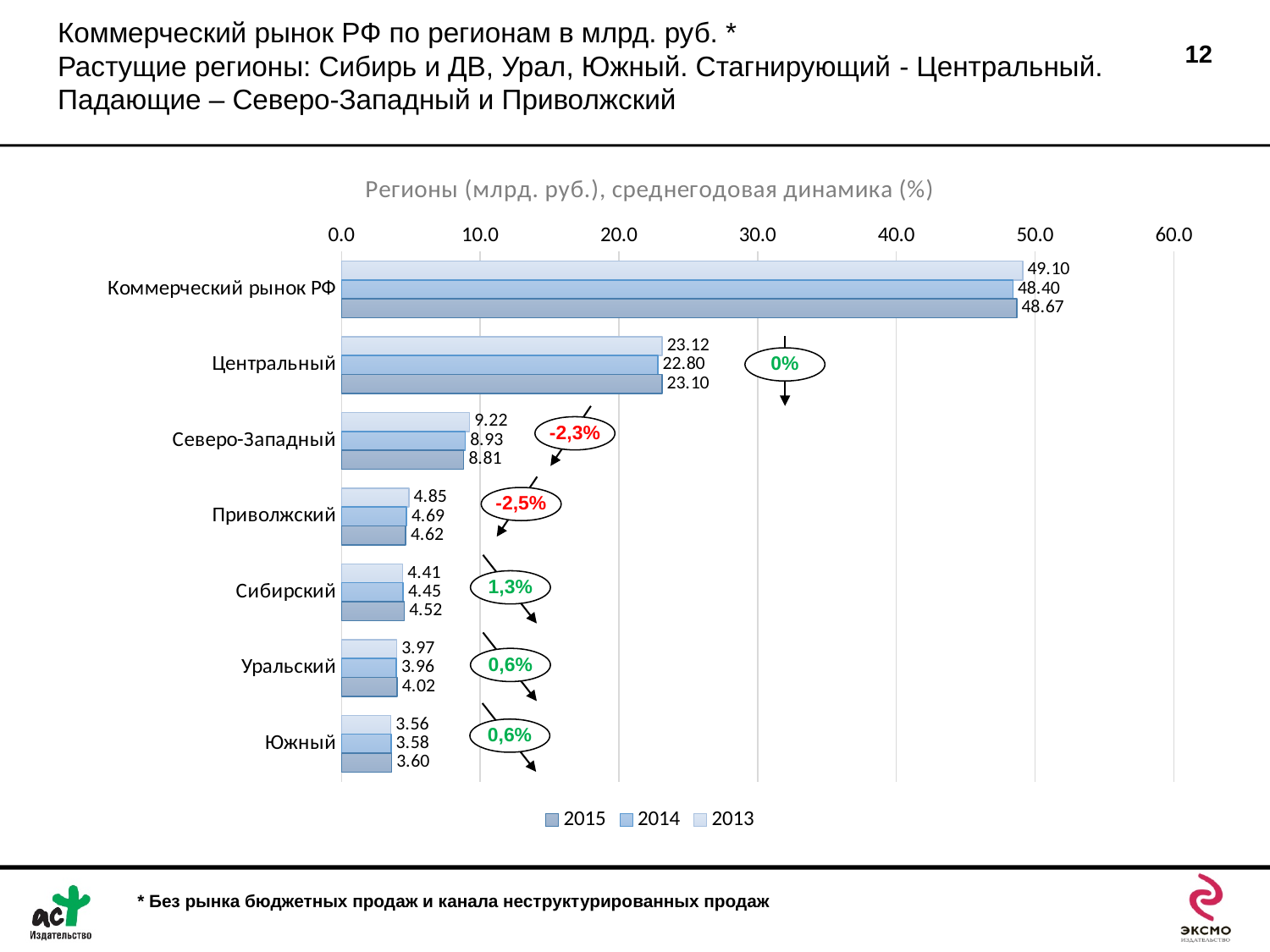
Which is larger: the 2015 value for Уральский or the 2015 value for Южный? Уральский What is the 2014 value for Сибирский? 4.45 What average annual change (%) is shown in the circle next to Северо-Западный? -2,3% What is the 2015 value for Центральный? 23.10 Which category has the highest 2013 value? Коммерческий рынок РФ What is the difference between the 2013 and 2015 values for Приволжский? 0.23 What kind of chart is shown on the slide? bar chart Which region (excluding Коммерческий рынок РФ) has the lowest 2015 value? Южный How many series does the legend list? 3 How many categories are shown on the vertical axis of the chart? 7 What is the 2013 value for Северо-Западный? 9.22 What is the 2015 value for Коммерческий рынок РФ? 48.67